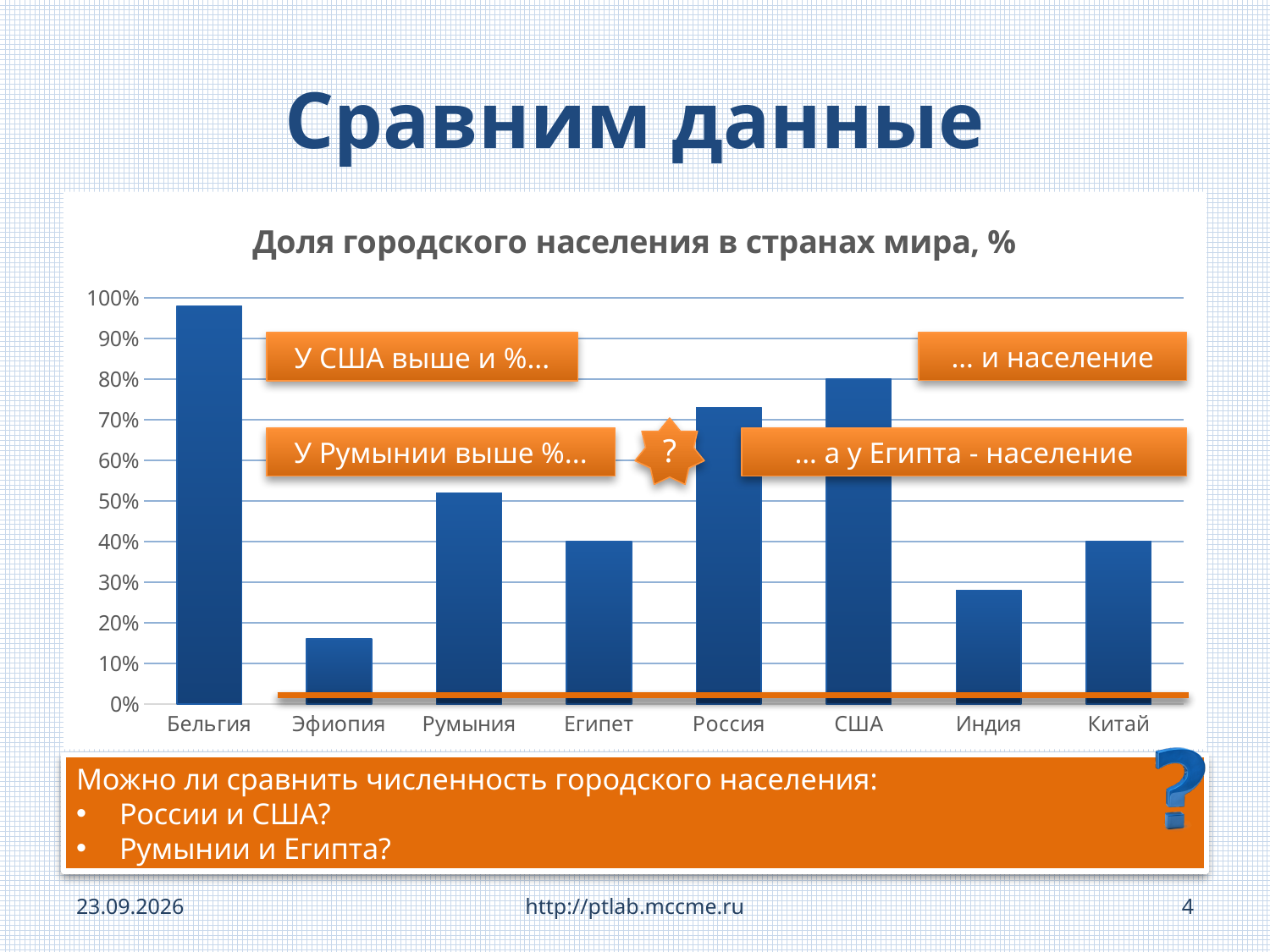
Which has a higher value in the chart, Россия or США? США Is the value for Эфиопия greater or less than 20%? less Which has a higher value in the chart, Румыния or Египет? Румыния What kind of chart is shown on the slide? bar chart What is the title of the chart? Доля городского населения в странах мира, % Is the value for Россия greater or less than 70%? greater How many countries are shown on the x axis of the chart? 8 Which country has the highest share of urban population in the chart? Бельгия Is the value for Бельгия greater or less than 90%? greater Which country has the lowest share of urban population in the chart? Эфиопия Which has a higher value in the chart, Индия or Эфиопия? Индия